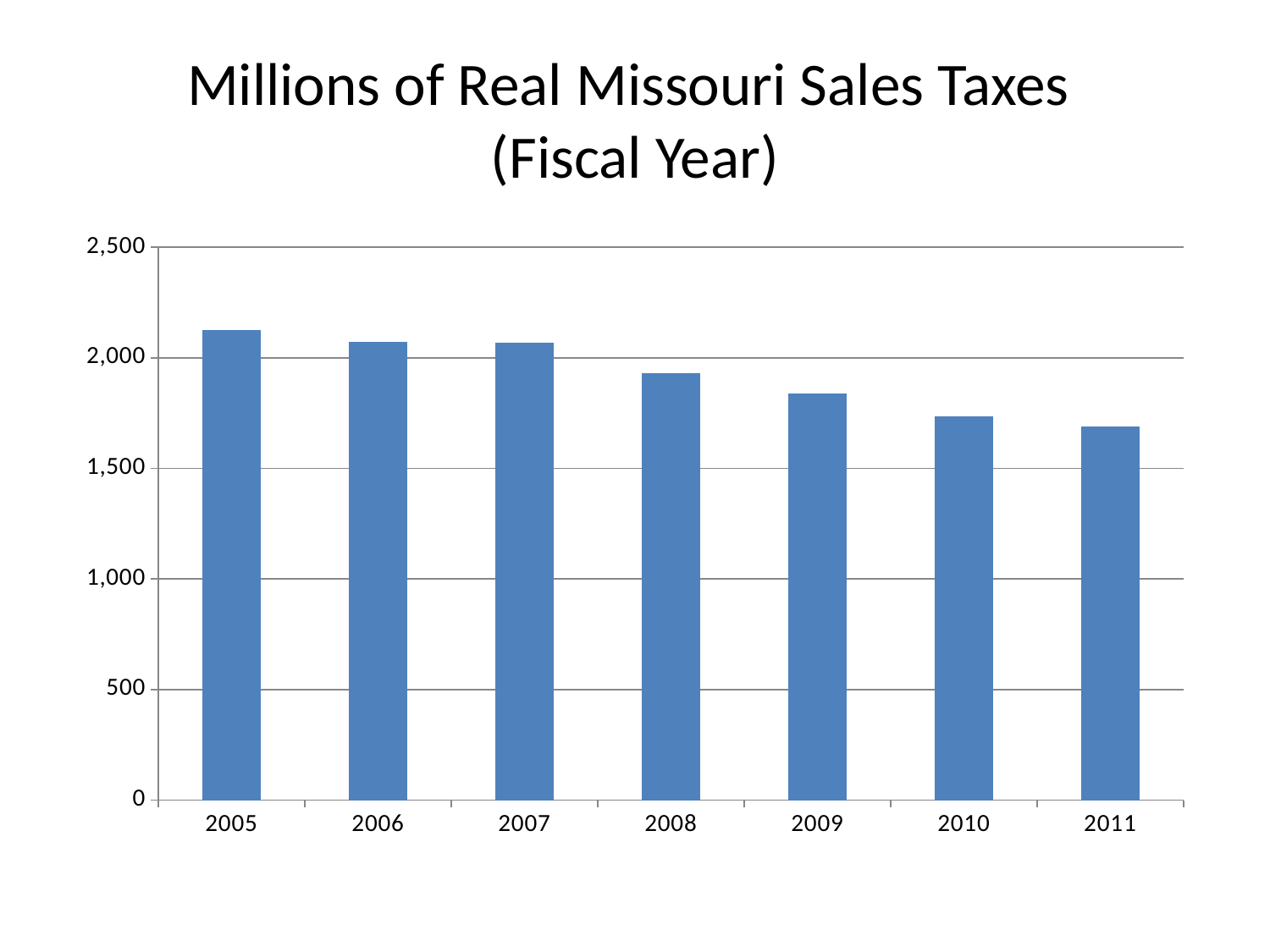
Do the values rise or fall from 2005 to 2011? fall What is the title of the chart? Millions of Real Missouri Sales Taxes (Fiscal Year) Is the value for 2011 greater or less than 2,000? less Which fiscal year has the highest value? 2005 Is the value for 2005 greater or less than 2,000? greater Which is larger, the value for 2005 or the value for 2011? 2005 What kind of chart is shown on the slide? bar chart How many fiscal years are plotted on the chart? 7 What is the highest value shown on the vertical axis? 2,500 Which fiscal year has the lowest value? 2011 Which is larger, the value for 2008 or the value for 2010? 2008 Is the value for 2009 greater or less than 1,500? greater